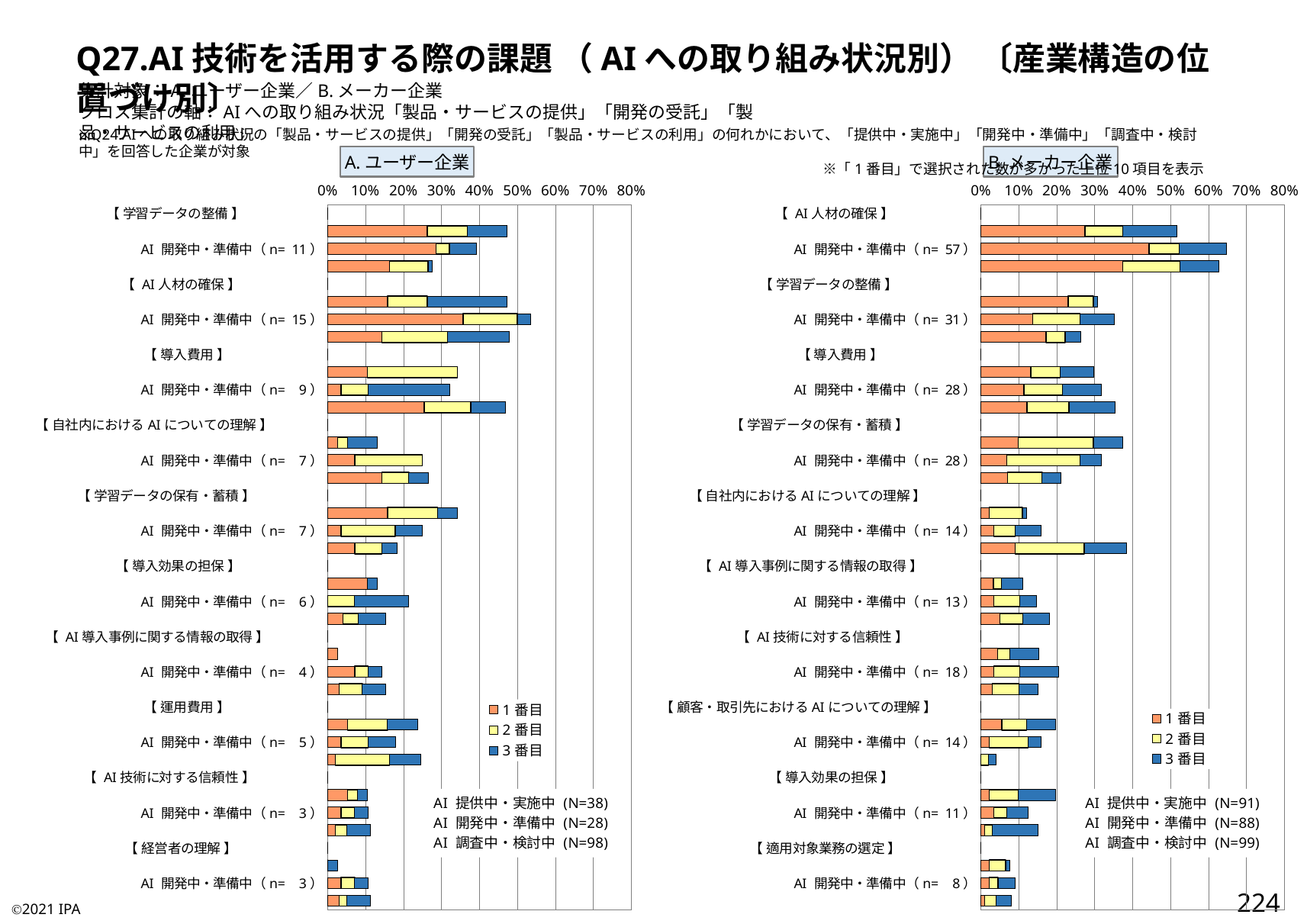
How many challenge categories (bracketed headings) are shown in the "B. メーカー企業" chart? 10 In the "B. メーカー企業" chart, which category has the longest stacked bar? AI人材の確保 How many series does the legend of the "B. メーカー企業" chart list? 3 In the "B. メーカー企業" chart, which AI 開発中・準備中 bar is longer: 【AI人材の確保】 or 【学習データの整備】? AI人材の確保 What kind of chart is the "A. ユーザー企業" chart on the left? Stacked bar chart In the "A. ユーザー企業" chart, which AI 開発中・準備中 bar is longer: 【AI人材の確保】 or 【導入費用】? AI人材の確保 What are the legend entries of the "A. ユーザー企業" chart? 1番目, 2番目, 3番目 In the "A. ユーザー企業" chart, is the total of the top (AI 提供中・実施中) bar for 【経営者の理解】 greater or less than 10%? less In the "B. メーカー企業" chart, what is the n value shown for AI 開発中・準備中 under 【AI人材の確保】? n= 57 What is the highest percentage tick shown on the x axis of the "A. ユーザー企業" chart? 80% In the "A. ユーザー企業" chart, is the total of the top (AI 提供中・実施中) bar for 【学習データの整備】 greater or less than 40%? greater In the "B. メーカー企業" chart, is the total of the AI 開発中・準備中 bar for 【AI人材の確保】 greater or less than 60%? greater